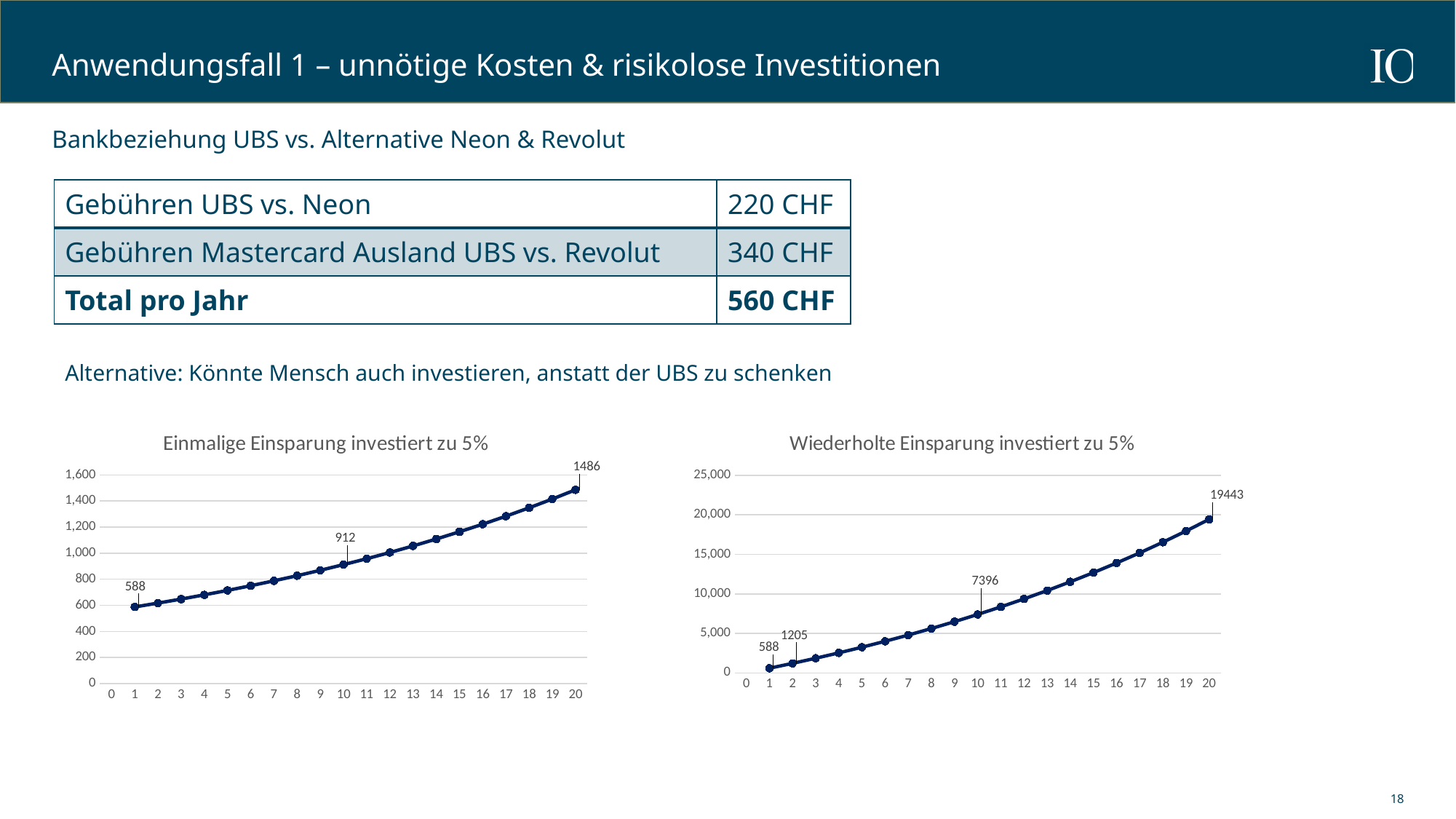
In the left chart 'Einmalige Einsparung investiert zu 5%', what is the value at year 20? 1486 In the right chart 'Wiederholte Einsparung investiert zu 5%', what is the value at year 2? 1205 In the left chart 'Einmalige Einsparung investiert zu 5%', what is the value at year 10? 912 What kind of chart is the left chart, 'Einmalige Einsparung investiert zu 5%'? line chart In the left chart 'Einmalige Einsparung investiert zu 5%', what is the value at year 1? 588 In the left chart 'Einmalige Einsparung investiert zu 5%', do the values rise or fall from year 1 to year 20? rise In the right chart 'Wiederholte Einsparung investiert zu 5%', is the value at year 15 greater or less than 10,000? greater In the right chart 'Wiederholte Einsparung investiert zu 5%', what is the difference between the value at year 10 and the value at year 2? 6191 In the left chart 'Einmalige Einsparung investiert zu 5%', is the value at year 5 greater or less than 800? less In the left chart 'Einmalige Einsparung investiert zu 5%', what is the difference between the value at year 20 and the value at year 1? 898 In the right chart 'Wiederholte Einsparung investiert zu 5%', what is the value at year 10? 7396 In the right chart 'Wiederholte Einsparung investiert zu 5%', what is the value at year 20? 19443